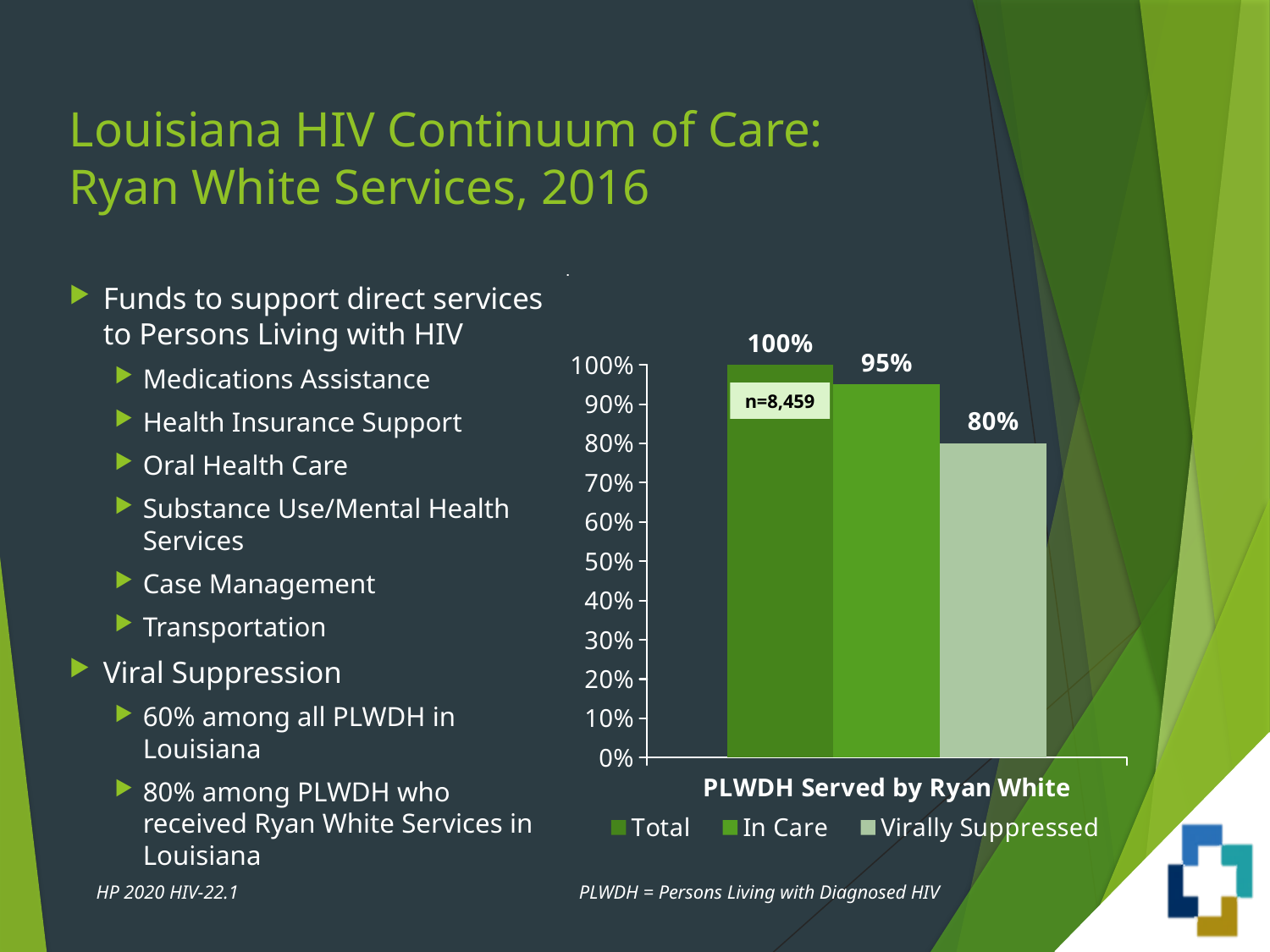
What sample size (n) is printed on the Total bar? n=8,459 What is the value for Virally Suppressed in the chart? 80% Which series has the lowest value in the chart? Virally Suppressed How many series does the legend list? 3 What is the value for In Care in the chart? 95% What is the difference between the Total value and the Virally Suppressed value? 20% Which series has the highest value in the chart? Total What kind of chart is shown on the slide? Bar chart What is the x-axis category label of the chart? PLWDH Served by Ryan White What is the difference between the In Care value and the Virally Suppressed value? 15% What is the value for Total in the chart? 100% Which is larger, the In Care value or the Virally Suppressed value? In Care